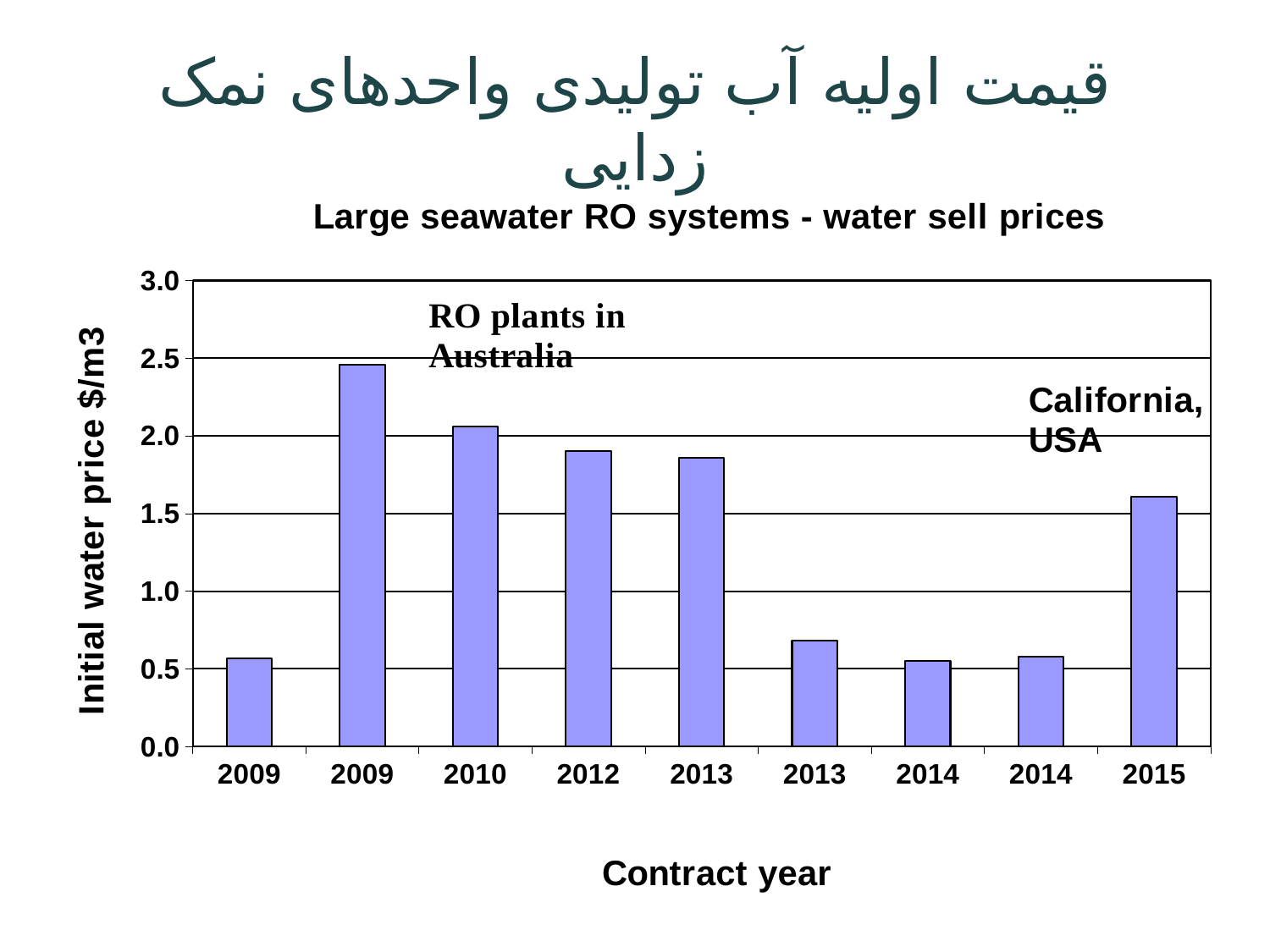
Is the value for the second 2013 bar greater or less than 1.0? less Is the value for the first 2009 bar greater or less than 1.0? less What is the title of the chart? Large seawater RO systems - water sell prices What is the label of the vertical axis? Initial water price $/m3 Is the value for 2015 greater or less than 1.5? greater Which is larger, the value for 2010 or the value for 2015? 2010 Which bar is the highest in the chart? the second 2009 bar What kind of chart is shown on the slide? bar chart How many bars are plotted in the chart? 9